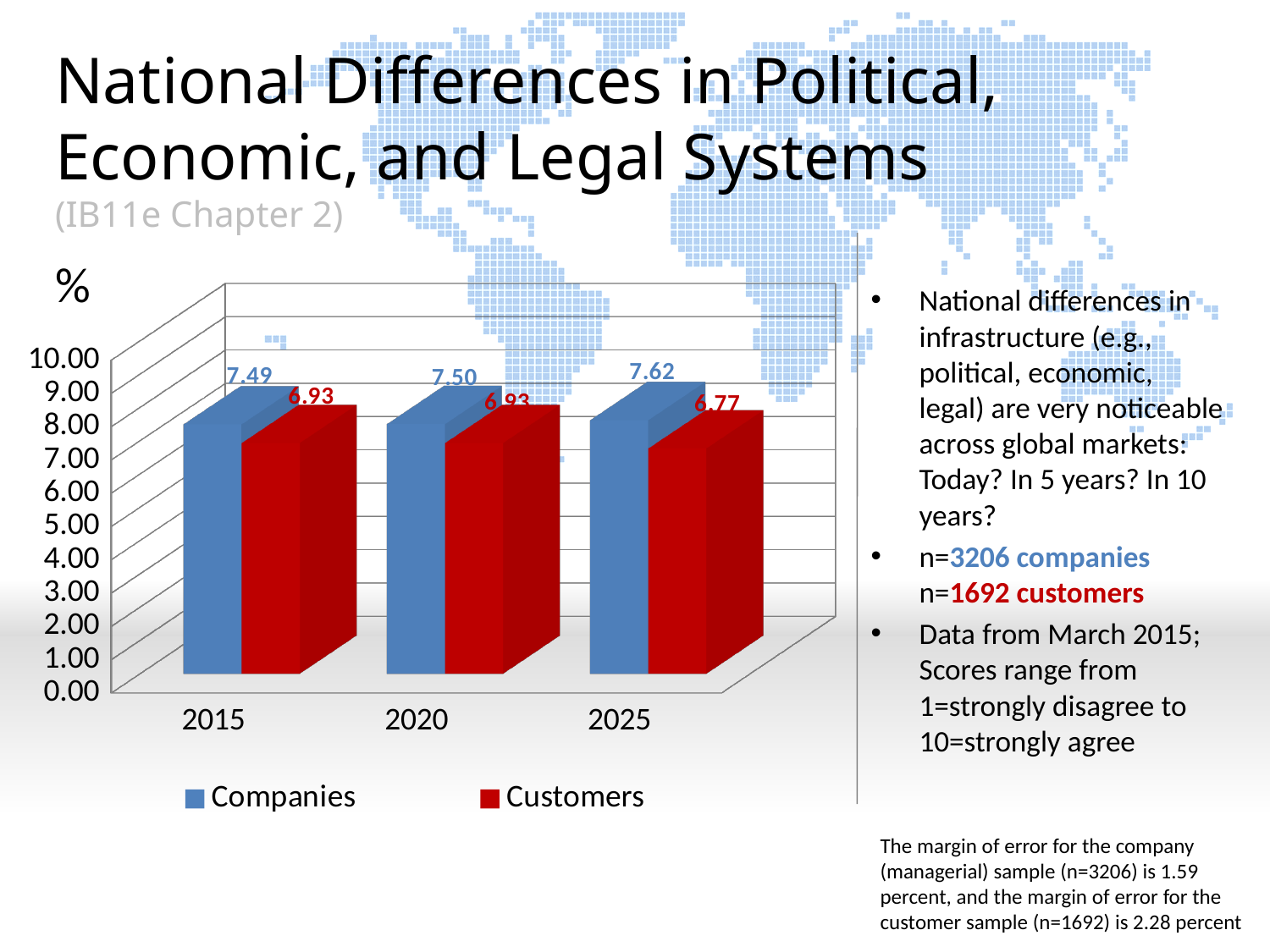
How many series does the legend list? 2 How many years are shown on the x axis? 3 What is the value for Customers in 2025? 6.77 By how much does the Companies value in 2025 exceed the Companies value in 2015? 0.13 What is the value for Companies in 2015? 7.49 Which is larger in 2025, the Companies value or the Customers value? Companies In which year is the Customers value lowest? 2025 What is the value for Companies in 2020? 7.50 What kind of chart is shown on the slide? bar chart In which year is the Companies value highest? 2025 What is the difference between the Companies and Customers values in 2015? 0.56 Is the value for Customers in 2025 greater or less than 7.00? less